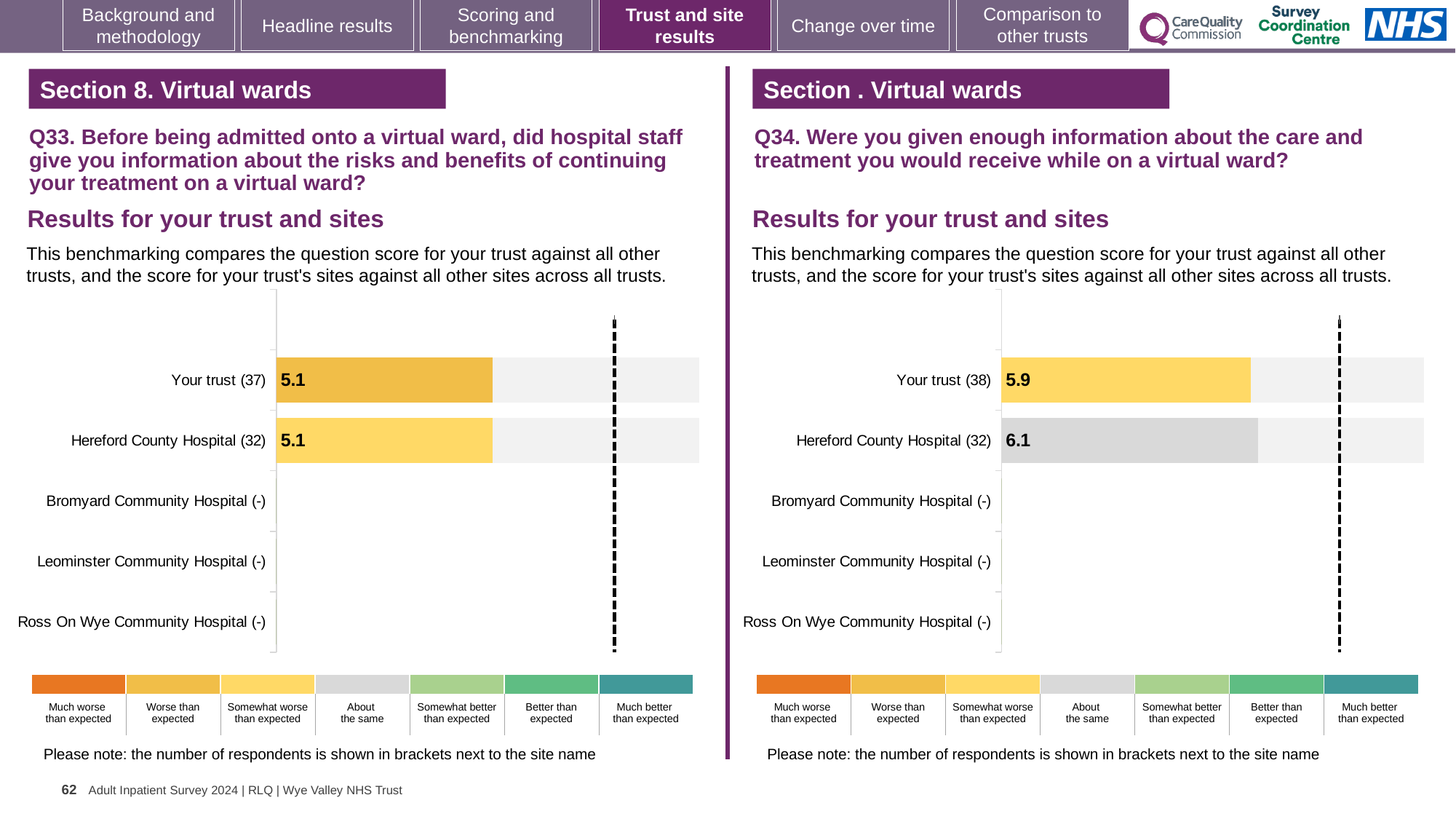
What type of chart is used on the Q34 chart (right)? Bar chart On the Q34 chart (right), what is the score for Your trust? 5.9 On the Q33 chart (left), what is the score for Hereford County Hospital? 5.1 How many site/trust categories are listed on the Q33 chart (left)? 5 On the Q34 chart (right), which has the higher score, Your trust or Hereford County Hospital? Hereford County Hospital On the Q33 chart (left), how many respondents are shown in brackets for Your trust? 37 On the Q33 chart (left), what is the score for Your trust? 5.1 On the Q34 chart (right), what is the difference between the Hereford County Hospital score and the Your trust score? 0.2 On the Q33 chart (left), how many sites have a score plotted? 2 On the Q33 chart (left), what is the difference between the Your trust score and the Hereford County Hospital score? 0 On the Q34 chart (right), what is the score for Hereford County Hospital? 6.1 On the Q34 chart (right), how many respondents are shown in brackets for Your trust? 38